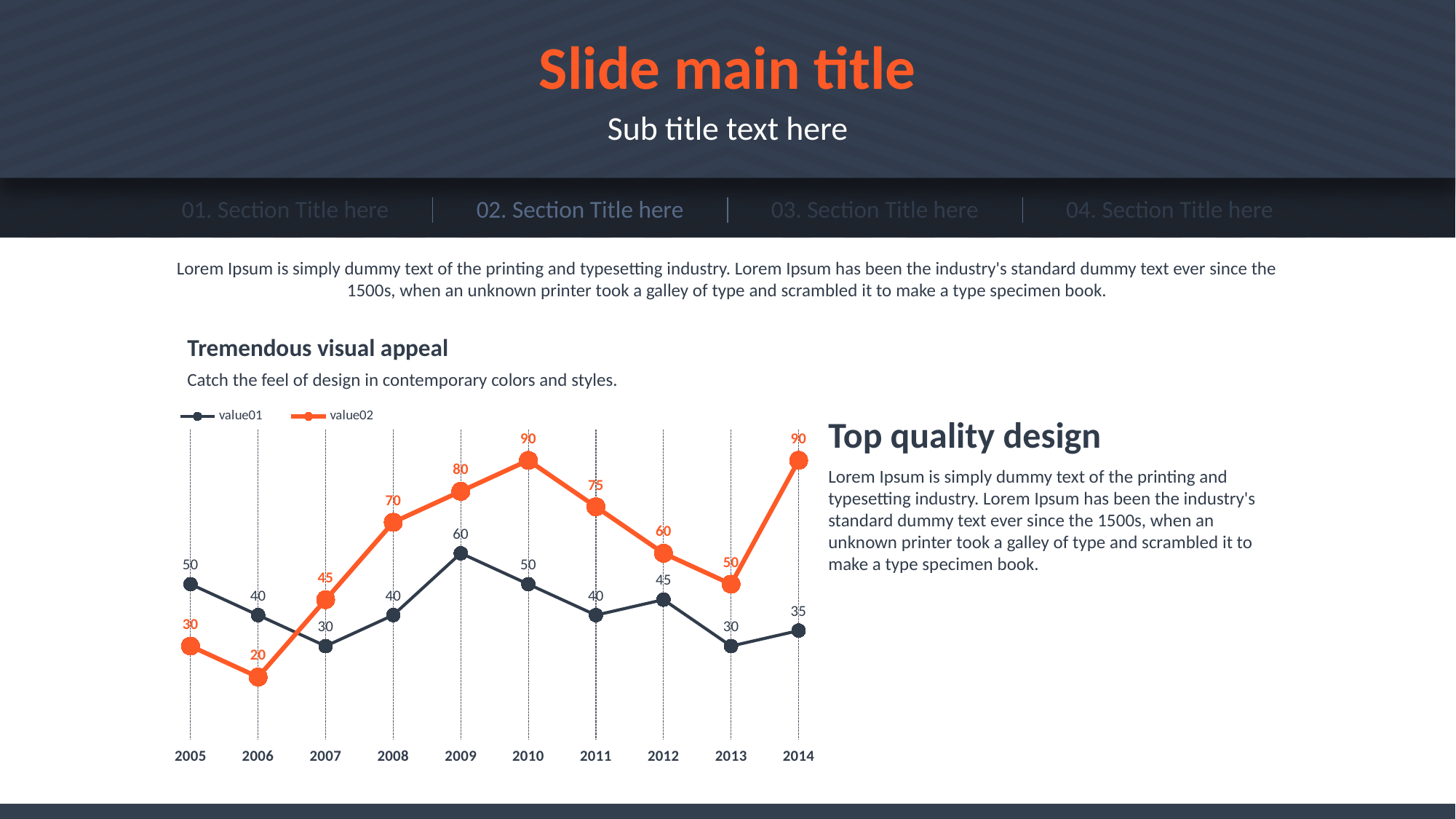
What is the value of value02 in 2008? 70 What is the value of value02 in 2006? 20 Does value02 rise or fall from 2010 to 2013? fall What kind of chart is shown on the slide? line chart What is the value of value01 in 2012? 45 How many series does the chart legend list? 2 Which colour is used for the value02 line in the chart? orange Which series has the larger value in 2005, value01 or value02? value01 In which year does value01 reach its highest value? 2009 How many years are plotted along the x axis of the chart? 10 What is the difference between value02 and value01 in 2010? 40 In which year does value02 reach its lowest value? 2006